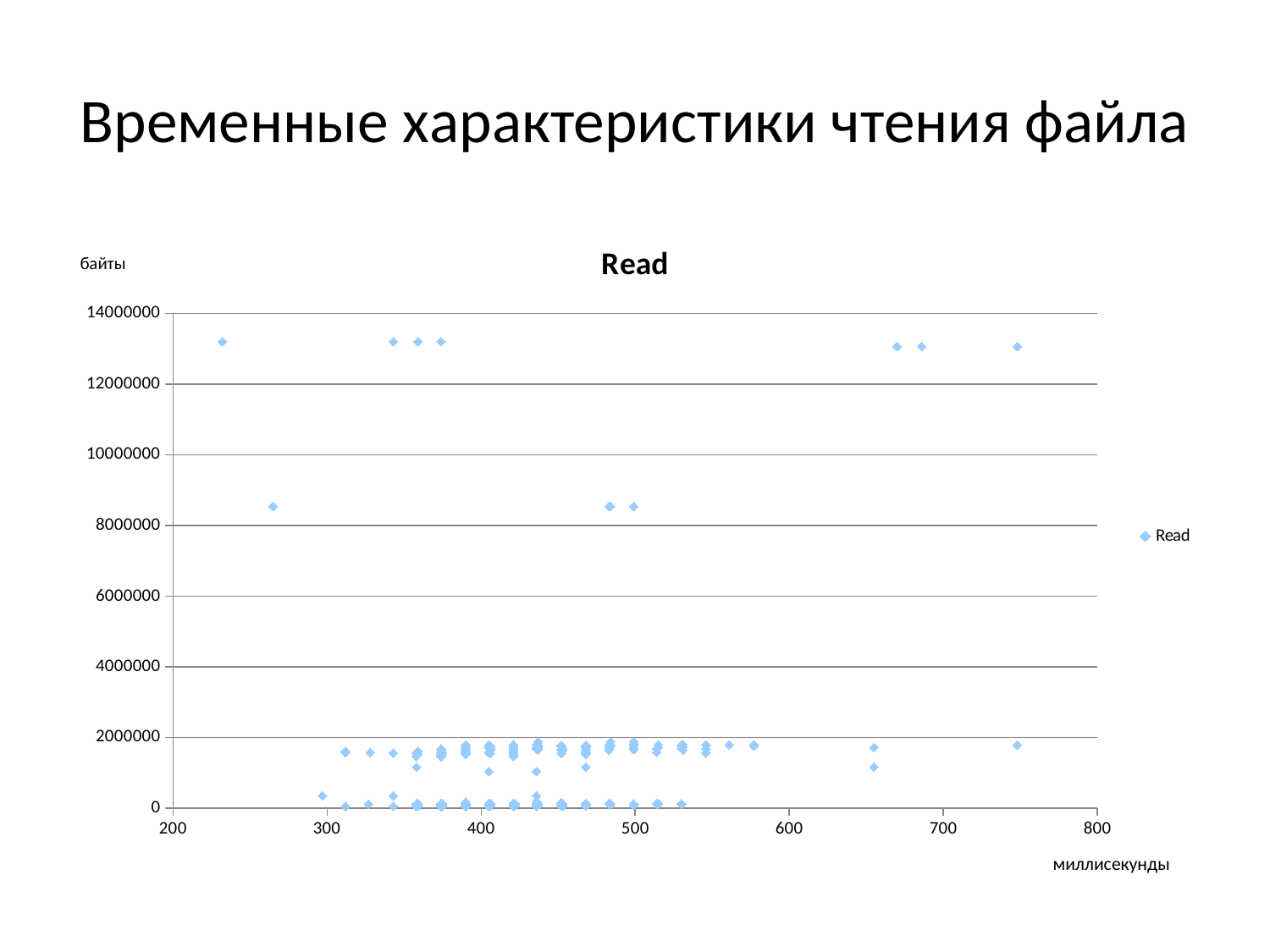
Is the value of the point at about 230 milliseconds greater or less than 12000000? greater What is the title of the chart? Read What kind of chart is shown on the slide? scatter chart Is the value of the point at about 265 milliseconds greater or less than 10000000? less What label is shown under the x axis of the chart? миллисекунды Is the value of the highest point near 670 milliseconds greater or less than 12000000? greater How many series does the legend list? 1 Which is higher: the point at about 230 milliseconds or the point at about 265 milliseconds? the point at about 230 milliseconds